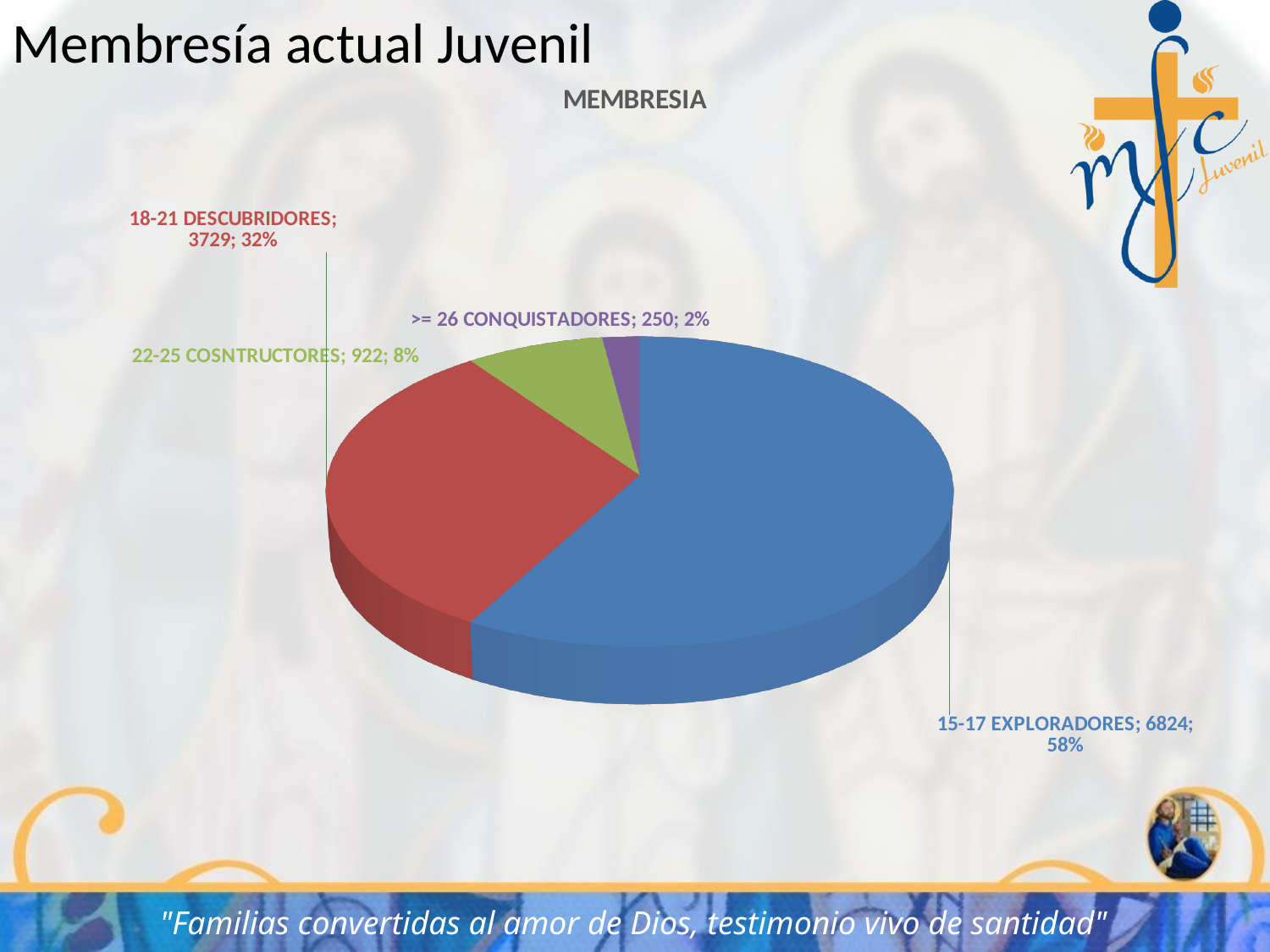
Which category has the largest slice of the pie? 15-17 EXPLORADORES Which is larger, the value for 22-25 COSNTRUCTORES or the value for >= 26 CONQUISTADORES? 22-25 COSNTRUCTORES How many slices does the pie chart have? 4 What is the value for 22-25 COSNTRUCTORES? 922 What is the value for 15-17 EXPLORADORES? 6824 What is the value for 18-21 DESCUBRIDORES? 3729 What is the value for >= 26 CONQUISTADORES? 250 What kind of chart is shown on the slide? Pie chart What is the difference between the values for 15-17 EXPLORADORES and 18-21 DESCUBRIDORES? 3095 What is the title of the chart? MEMBRESIA What share of the pie does 18-21 DESCUBRIDORES represent? 32% Which category has the smallest slice of the pie? >= 26 CONQUISTADORES